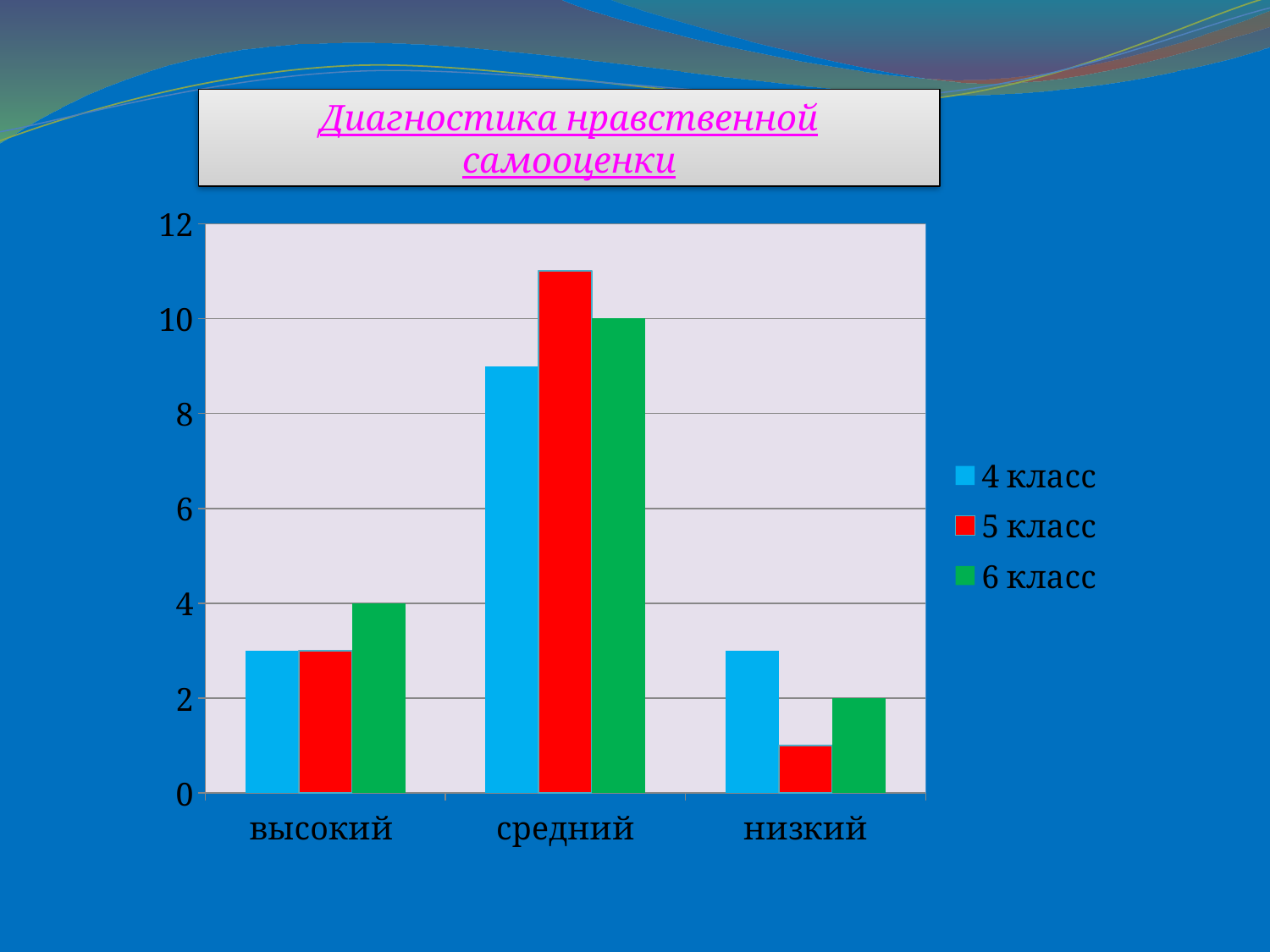
In the низкий category, which is larger: the value for 4 класс or the value for 5 класс? 4 класс What is the value for 6 класс in the средний category? 10 What is the value for 6 класс in the высокий category? 4 Which category has the highest value for 5 класс? средний What is the title of the chart? Диагностика нравственной самооценки What kind of chart is shown on the slide? bar chart How many categories are shown on the x axis? 3 How many series does the legend list? 3 What is the value for 6 класс in the низкий category? 2 Which category has the lowest value for 5 класс? низкий Is the value for 5 класс in the средний category greater or less than 10? greater Is the value for 4 класс in the средний category greater or less than 10? less